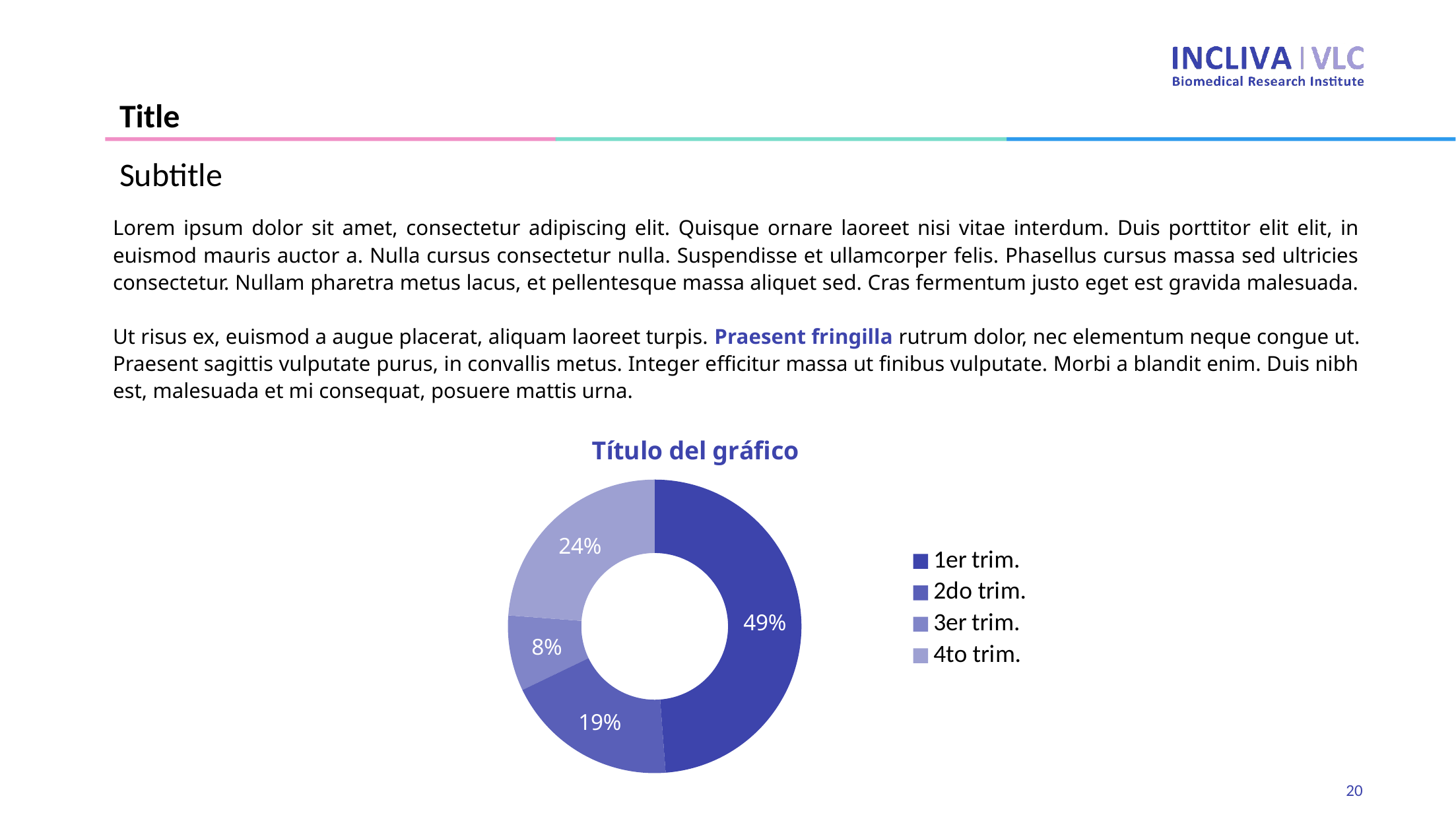
How many entries does the legend list? 4 How many categories does the chart show? 4 Which category has the smallest slice? 3er trim. What is the title of the chart? Título del gráfico What kind of chart is shown on the slide? Doughnut chart What share of the chart does 1er trim. represent? 49% What share of the chart does 3er trim. represent? 8% What share of the chart does 2do trim. represent? 19% What is the difference in percentage points between 1er trim. and 4to trim.? 25 Which category has the largest slice? 1er trim. Which is larger, the slice for 2do trim. or the slice for 4to trim.? 4to trim.